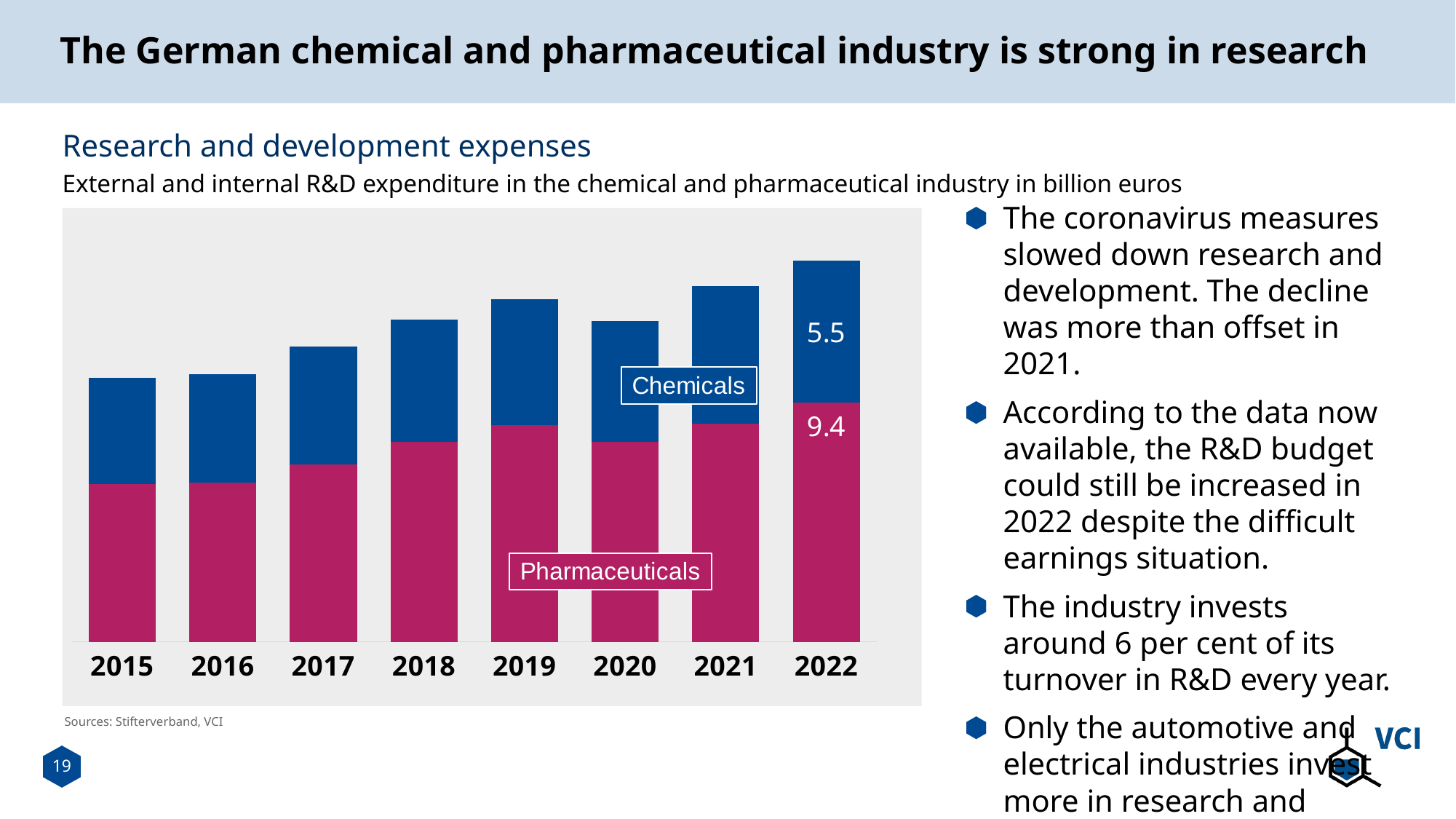
In what unit are the R&D expenditures given? Billion euros What is the value for Chemicals in 2022? 5.5 Which year has the larger total bar, 2019 or 2020? 2019 What kind of chart is shown on the slide? Stacked bar chart Do the total bars generally rise or fall from 2015 to 2022? Rise What is the total R&D expenditure shown for the 2022 bar? 14.9 How many years are shown on the x axis? 8 What is the value for Pharmaceuticals in 2022? 9.4 What is the difference between the Pharmaceuticals and Chemicals values in 2022? 3.9 In 2022, which segment is larger, Chemicals or Pharmaceuticals? Pharmaceuticals How many series does the chart show? 2 Which year has the highest total R&D expenditure? 2022